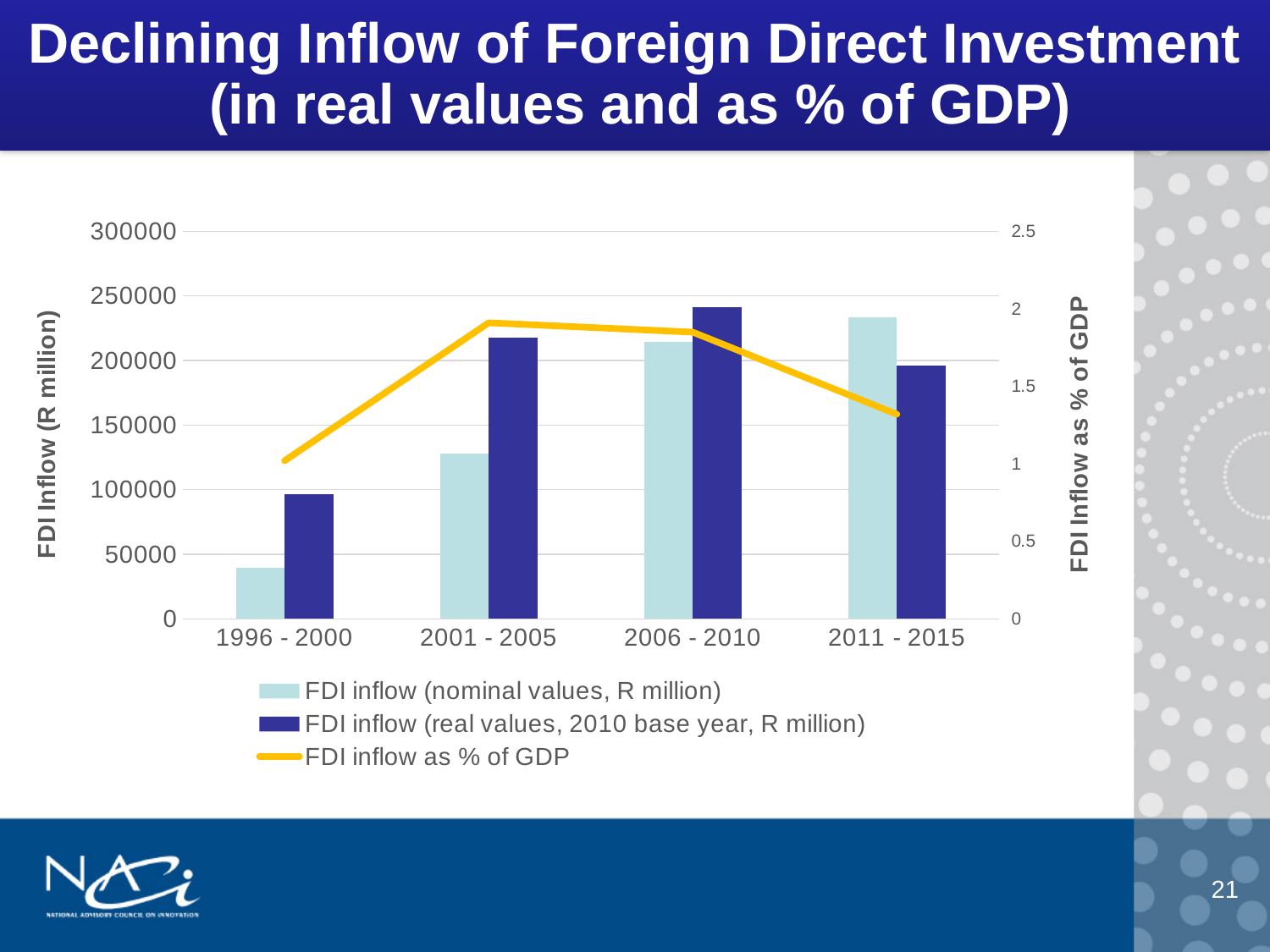
For 2011 - 2015, which is larger: the nominal FDI inflow or the real FDI inflow? Nominal FDI inflow Does the FDI inflow as % of GDP rise or fall from 2006 - 2010 to 2011 - 2015? Fall Is the FDI inflow as % of GDP for 1996 - 2000 greater or less than 1.5? less Is the FDI inflow (real values, 2010 base year) for 2006 - 2010 greater or less than 200000? greater How many time periods are shown on the x axis? 4 Which period has the highest FDI inflow (nominal values, R million)? 2011 - 2015 Which period has the lowest FDI inflow (nominal values, R million)? 1996 - 2000 How many series does the legend list? 3 Which period has the lowest FDI inflow as % of GDP? 1996 - 2000 What kind of chart is shown on the slide? A bar chart combined with a line Which period has the highest FDI inflow (real values, 2010 base year, R million)? 2006 - 2010 Is the FDI inflow (nominal values) for 1996 - 2000 greater or less than 50000? less